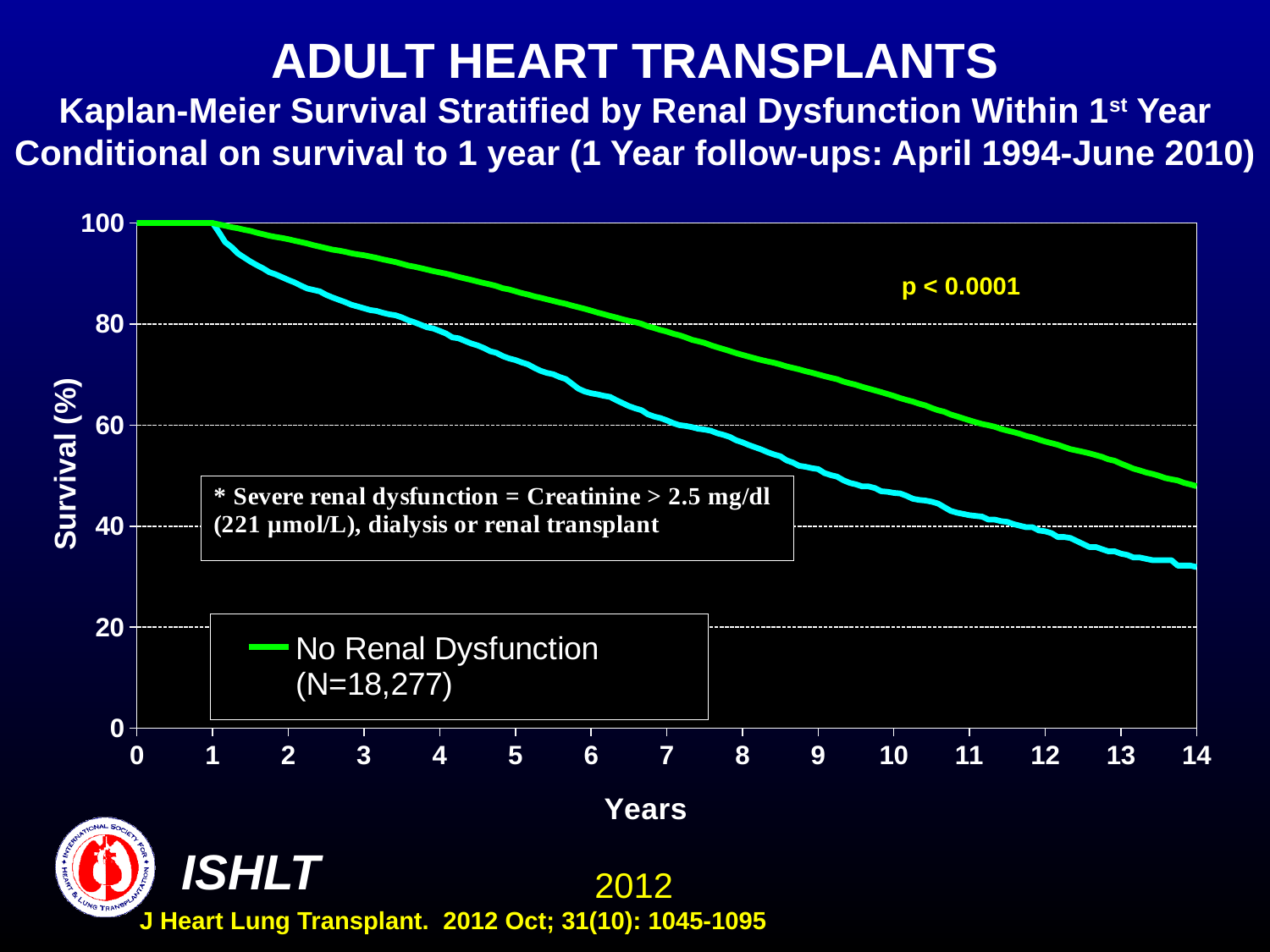
Is the survival shown by the cyan line at 10 years greater or less than 60%? less How many survival curves are plotted on the chart? 2 Is the survival for No Renal Dysfunction at 14 years greater or less than 40%? greater Does survival rise or fall as the number of years increases? Fall Is the survival shown by the cyan line at 5 years greater or less than 60%? greater What is the N for the No Renal Dysfunction group shown in the legend? 18,277 At 10 years, which line shows higher survival, the green line or the cyan line? Green line What is the p-value shown on the chart? p < 0.0001 What kind of chart is shown on the slide? Line chart What is the maximum value shown on the x axis (Years)? 14